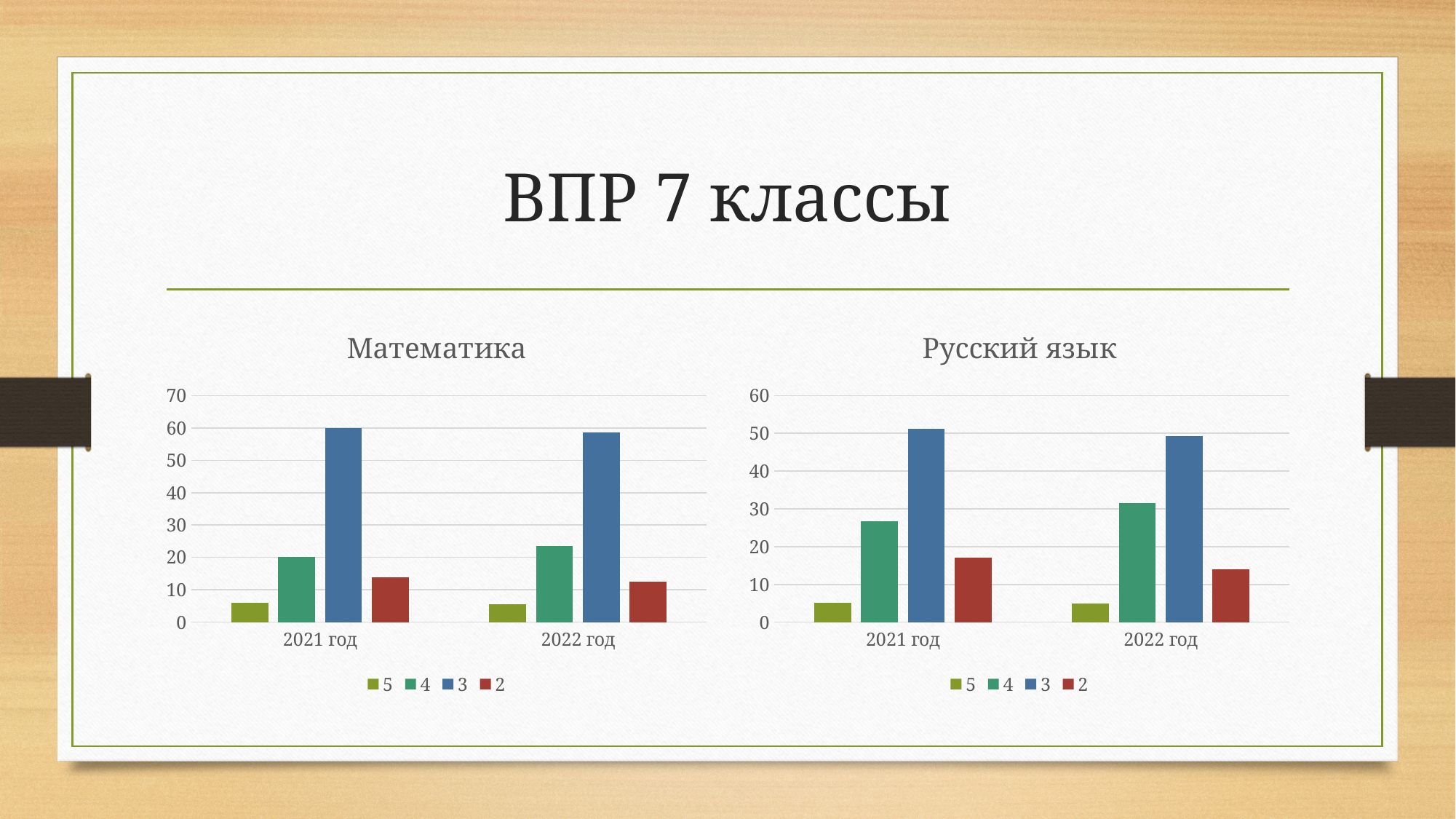
In the "Математика" chart, is the value of series 3 for 2022 год greater or less than 50? greater What kind of chart is the "Математика" chart? bar chart In the "Математика" chart, is series 2 larger in 2021 год or 2022 год? 2021 год What are the legend entries of the "Математика" chart? 5, 4, 3, 2 In the "Русский язык" chart, does series 3 rise or fall from 2021 год to 2022 год? fall How many series does the legend of the "Русский язык" chart list? 4 In the "Математика" chart, which series has the highest value for 2021 год? 3 In the "Русский язык" chart, which series has the lowest value for 2022 год? 5 In the "Русский язык" chart, is the value of series 2 for 2022 год greater or less than 20? less In the "Русский язык" chart, is series 4 larger in 2021 год or 2022 год? 2022 год In the "Русский язык" chart, is the value of series 4 for 2021 год greater or less than 30? less How many categories are shown on the x axis of the "Математика" chart? 2